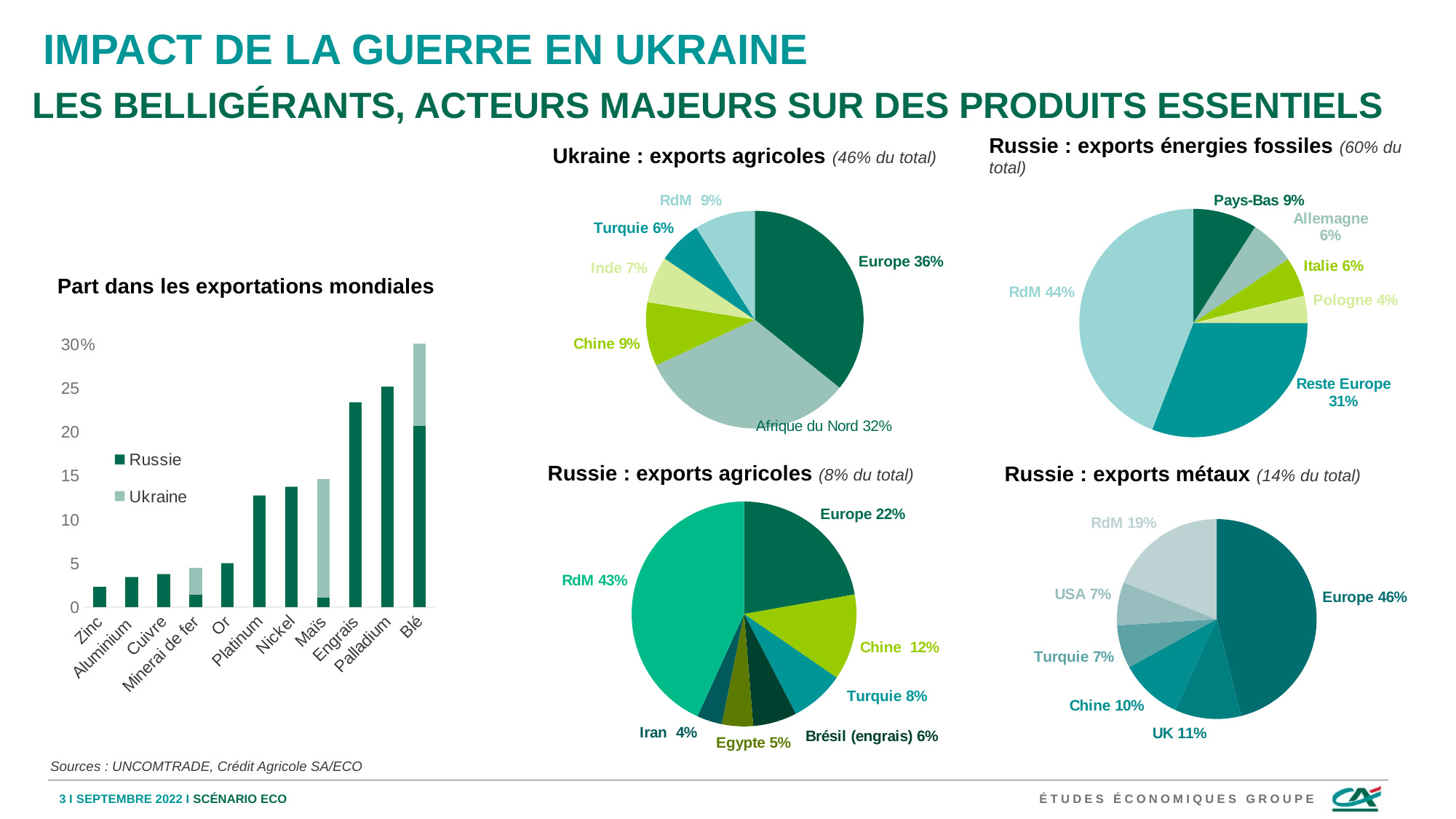
In the 'Part dans les exportations mondiales' chart, how many series does the legend list? 2 In the 'Russie : exports métaux' pie chart, what share goes to Europe? 46% In the 'Part dans les exportations mondiales' chart, which product has the highest total bar? Blé In the 'Ukraine : exports agricoles' pie chart, which destination has the largest share? Europe In the 'Part dans les exportations mondiales' chart, how many product categories are shown on the x axis? 11 In the 'Part dans les exportations mondiales' chart, is the value for Or greater or less than 10? less In the 'Ukraine : exports agricoles' pie chart, what share goes to Afrique du Nord? 32% In the 'Russie : exports agricoles' pie chart, what is the difference between the shares of Europe and Chine? 10% In the 'Russie : exports métaux' pie chart, which is larger, the share of UK or the share of Chine? UK In the 'Part dans les exportations mondiales' chart, is the value for Palladium greater or less than 20? greater In the 'Part dans les exportations mondiales' chart, what kind of chart is it? bar chart In the 'Russie : exports énergies fossiles' pie chart, what share goes to Reste Europe? 31%